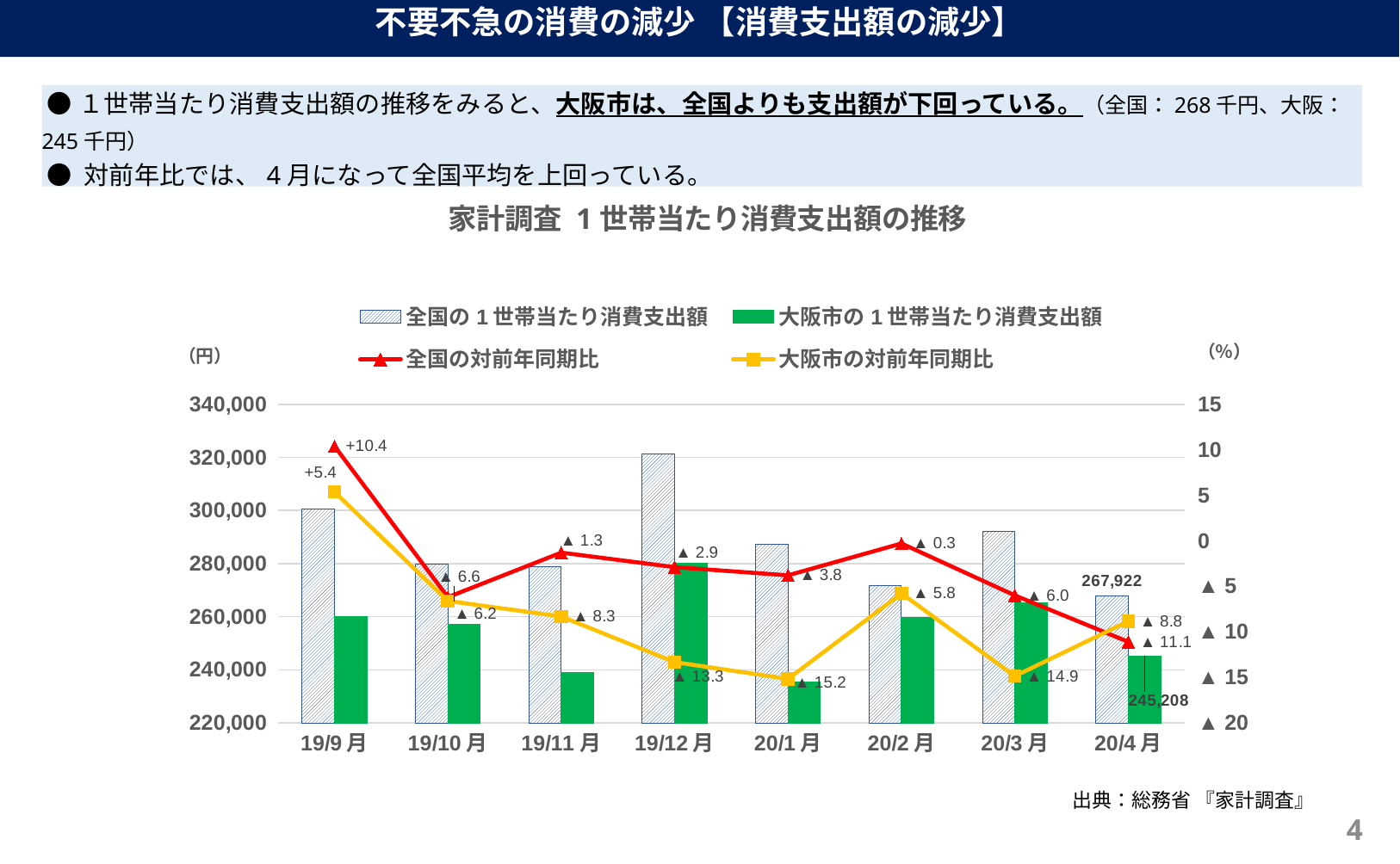
What is the value of 全国の対前年同期比 for 19/9月? +10.4 What is the difference between the national and Osaka City consumption expenditure in 20/4月? 22,714 Is the value of 全国の1世帯当たり消費支出額 for 20/1月 greater or less than 280,000? greater In which month is the 大阪市の1世帯当たり消費支出額 bar the lowest? 20/1月 What is the value of 大阪市の1世帯当たり消費支出額 for 20/4月? 245,208 What is the value of 全国の1世帯当たり消費支出額 for 20/4月? 267,922 What kind of chart is shown on the slide? A combined bar and line chart How many months are shown on the x axis? 8 What is the title of the chart? 家計調査 1世帯当たり消費支出額の推移 In which month is the 全国の1世帯当たり消費支出額 bar the highest? 19/12月 How many series does the legend list? 4 What is the value of 大阪市の対前年同期比 for 20/1月? ▲15.2